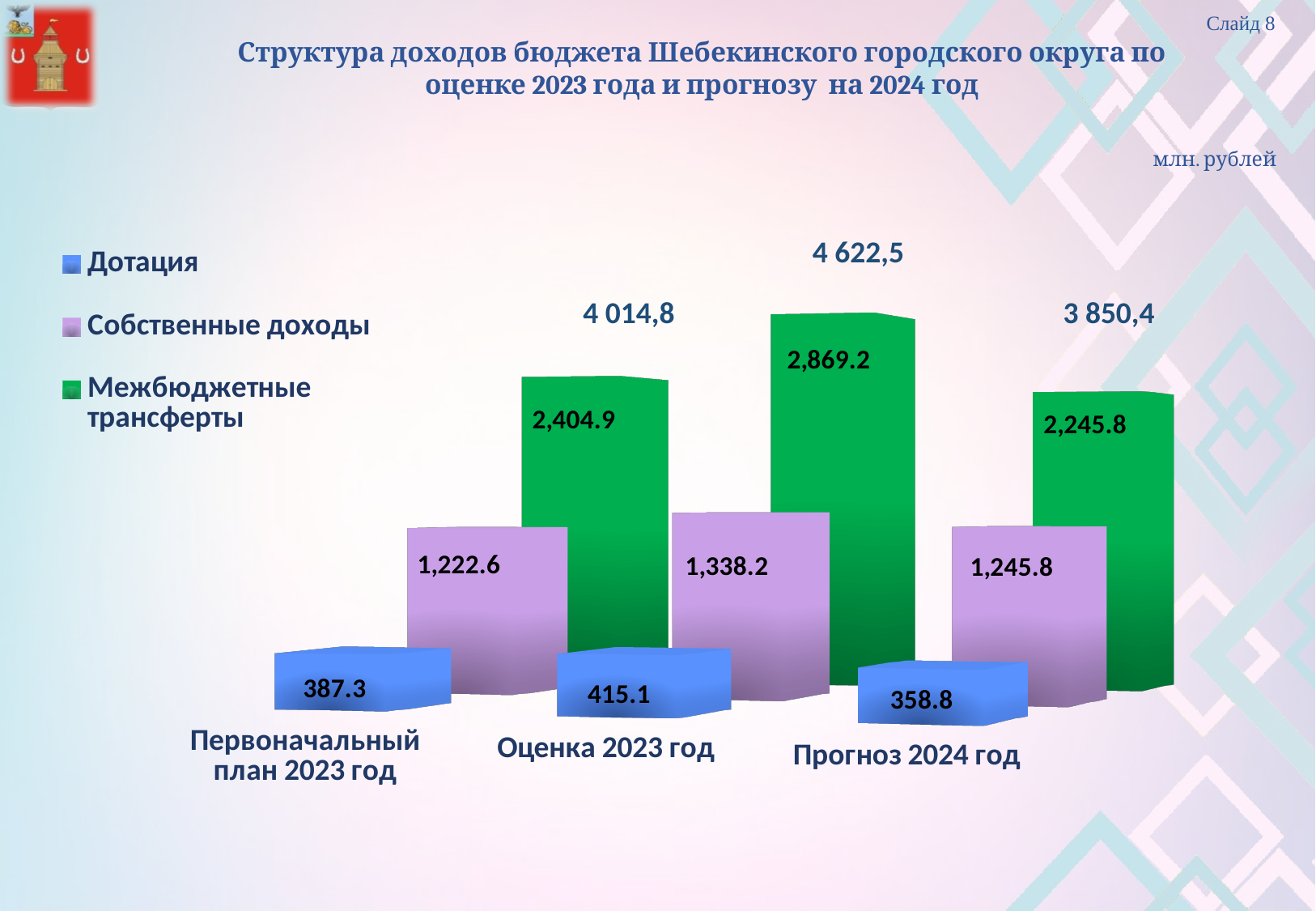
How many series does the legend list? 3 What total is printed above the bars for Оценка 2023 год? 4 622,5 How many categories are shown on the x axis? 3 What is the difference between Собственные доходы for Оценка 2023 год and for Прогноз 2024 год? 92.4 What is the value of Межбюджетные трансферты for Прогноз 2024 год? 2,245.8 In which category is Межбюджетные трансферты the highest? Оценка 2023 год Which is larger: Дотация for Первоначальный план 2023 год or for Оценка 2023 год? Оценка 2023 год In which category is Дотация the lowest? Прогноз 2024 год What is the difference between Межбюджетные трансферты for Оценка 2023 год and for Первоначальный план 2023 год? 464.3 What is the value of Собственные доходы for Оценка 2023 год? 1,338.2 What kind of chart is shown on the slide? Bar chart What is the value of Дотация for Первоначальный план 2023 год? 387.3